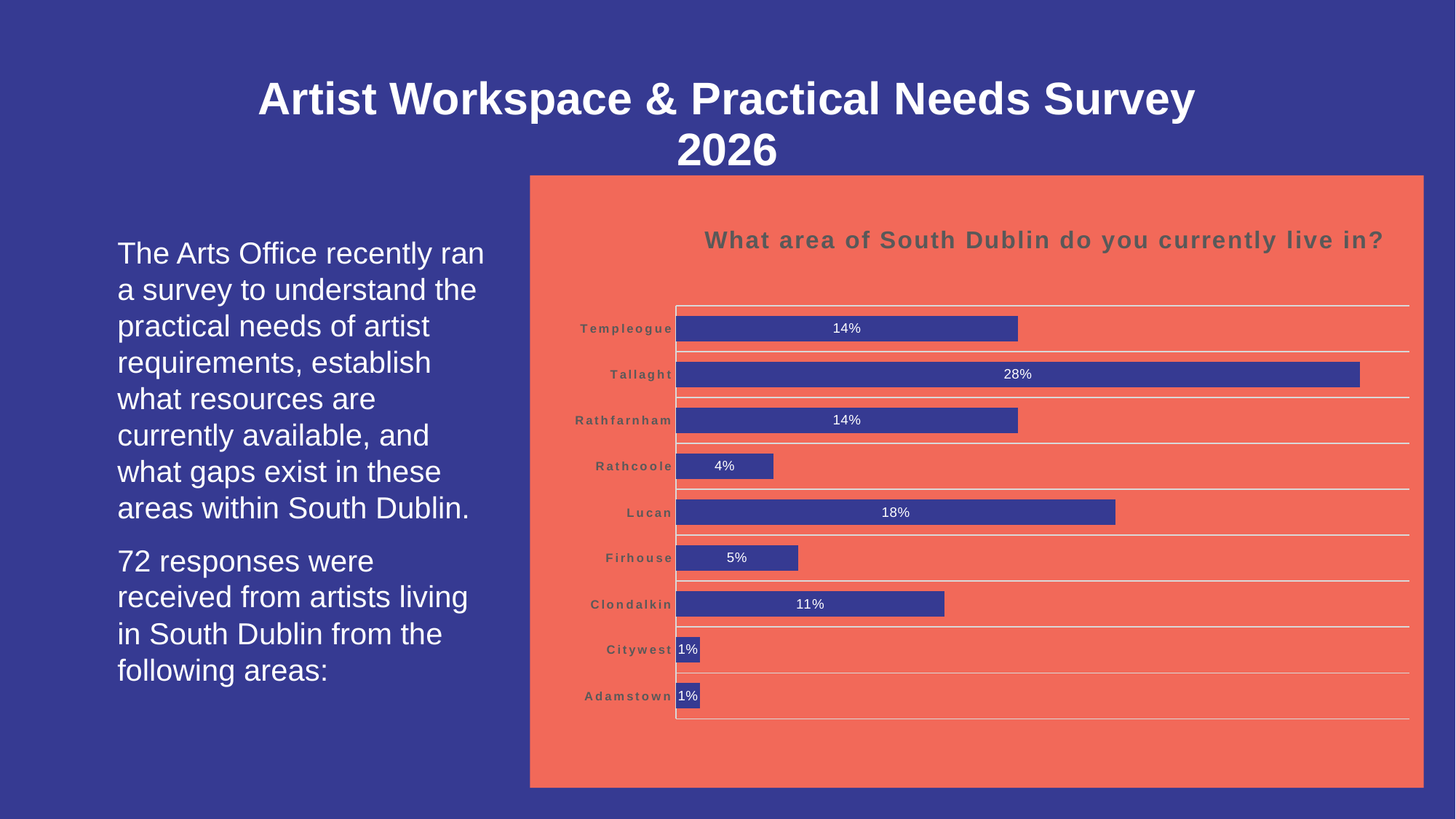
What is the value shown for Rathcoole? 4% What is the title of the chart? What area of South Dublin do you currently live in? What is the difference between the values for Templeogue and Firhouse? 9% Which has a larger value, Clondalkin or Rathfarnham? Rathfarnham What type of chart is shown on the slide? Bar chart Which has a larger value, Firhouse or Rathcoole? Firhouse What percentage of respondents live in Lucan? 18% How many areas are shown in the chart? 9 What is the difference between the values for Tallaght and Lucan? 10% What is the value shown for Clondalkin? 11% Which area has the highest percentage of respondents? Tallaght What percentage of respondents live in Tallaght? 28%